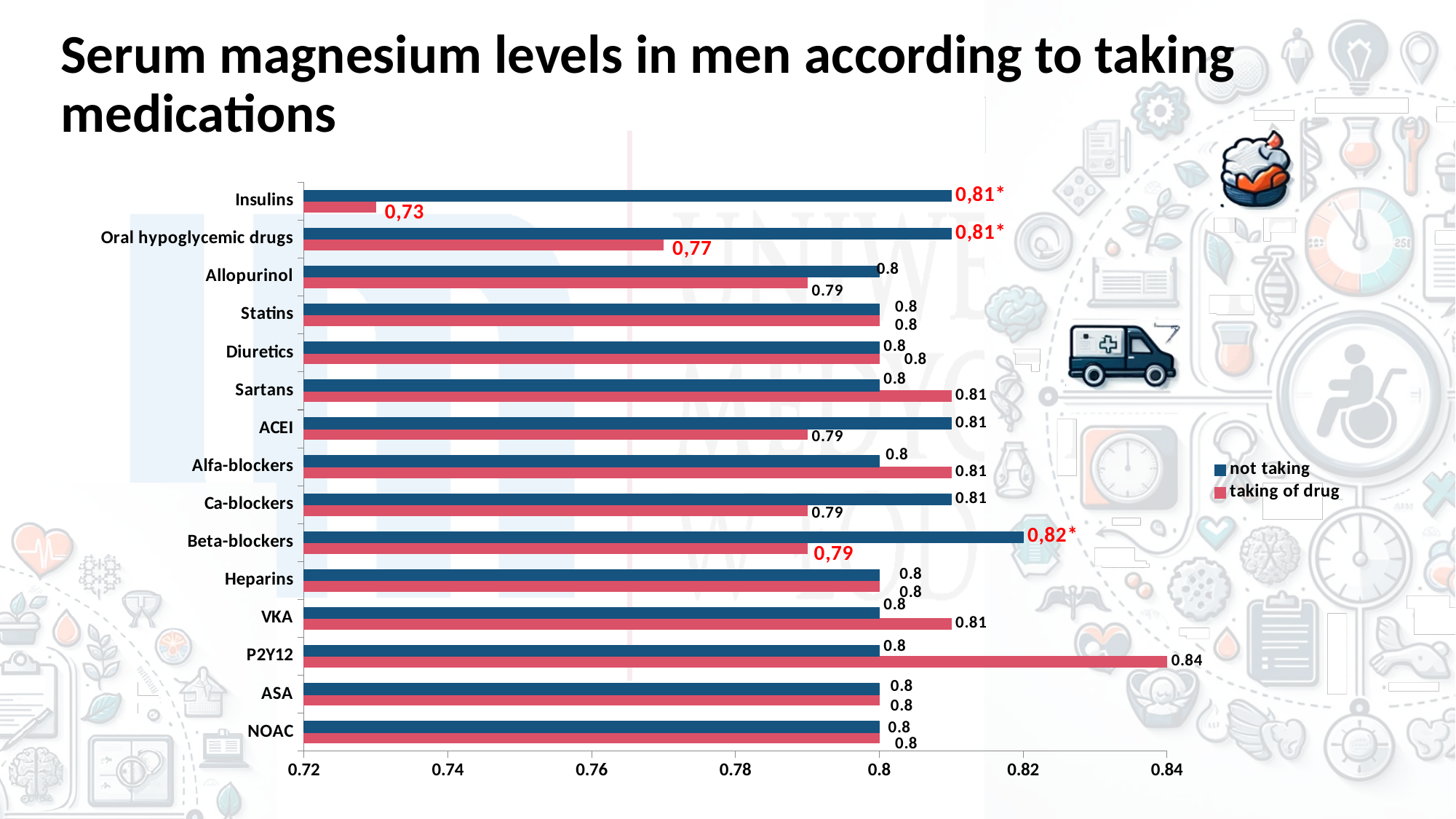
Which category has the highest 'taking of drug' value? P2Y12 What is the serum magnesium level for men taking insulins (the 'taking of drug' series)? 0,73 For Insulins, which is larger: the 'not taking' value or the 'taking of drug' value? not taking How many medication categories are shown on the chart? 15 Which category has the lowest 'taking of drug' value? Insulins What is the 'not taking' value for Beta-blockers? 0,82* What type of chart is shown on the slide? Bar chart For P2Y12, which is larger: the 'not taking' value or the 'taking of drug' value? taking of drug What is the 'taking of drug' value for Oral hypoglycemic drugs? 0,77 What is the 'taking of drug' value for P2Y12? 0.84 How many series does the legend list? 2 Which category has the highest 'not taking' value? Beta-blockers